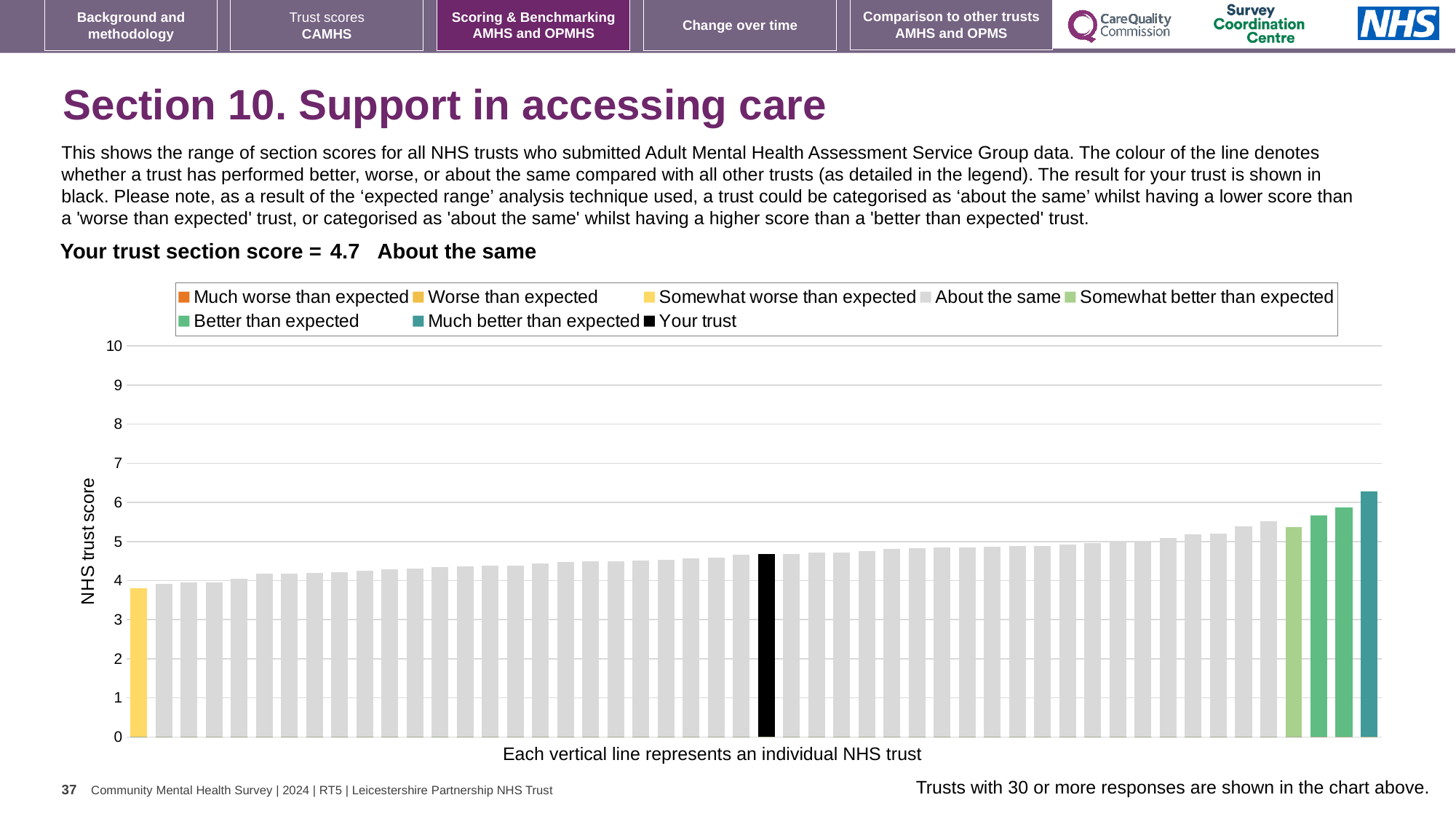
Is the value of the black 'Your trust' bar greater or less than 4? greater Is the value of the tallest bar (the rightmost, teal bar) greater or less than 6? greater Is the value of the tallest bar (the rightmost, teal bar) greater or less than 7? less What is the section score for your trust shown on the slide? 4.7 What kind of chart is shown on the slide? bar chart How many entries does the chart legend list? 8 Which legend category does the shortest bar in the chart belong to? Somewhat worse than expected Which legend category does the tallest bar in the chart belong to? Much better than expected What is the title of the vertical axis of the chart? NHS trust score Do the bar values rise or fall from left to right across the chart? rise